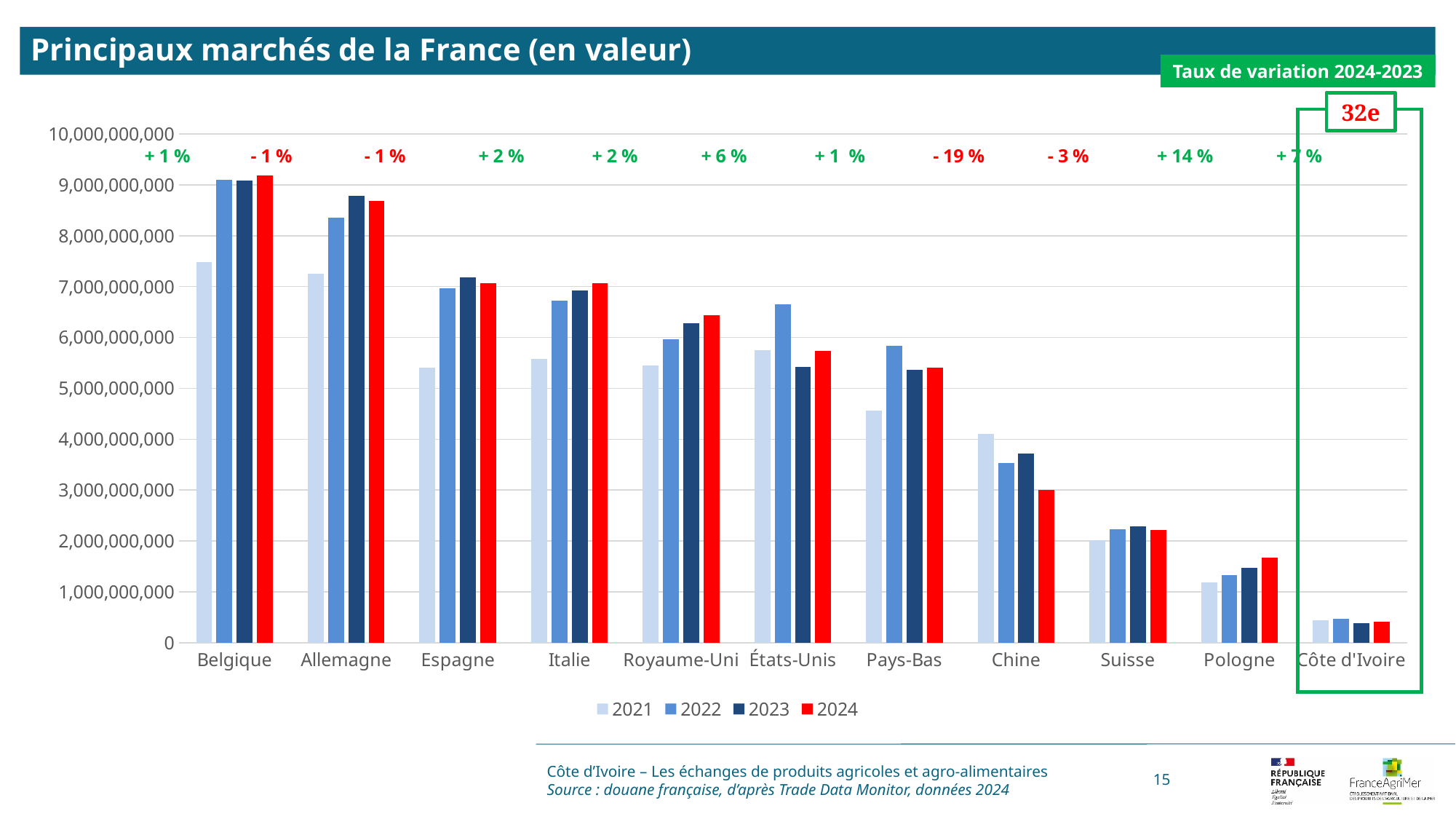
Is the 2024 value for Belgique greater or less than 9,000,000,000? greater Is the 2024 value for Pologne greater or less than 2,000,000,000? less Which country has the lowest 2024 value? Côte d'Ivoire Which is larger, the 2024 value for Allemagne or the 2024 value for Espagne? Allemagne What is the 2024-2023 variation rate shown above Chine? - 19 % Which country has the highest 2024-2023 variation rate printed on the chart? Pologne Which country has the highest 2024 value? Belgique What rank label is shown in the green box above Côte d'Ivoire? 32e How many series does the legend list? 4 What is the 2024-2023 variation rate shown above Pologne? + 14 % What kind of chart is shown on the slide? bar chart How many countries are shown on the x axis of the chart? 11